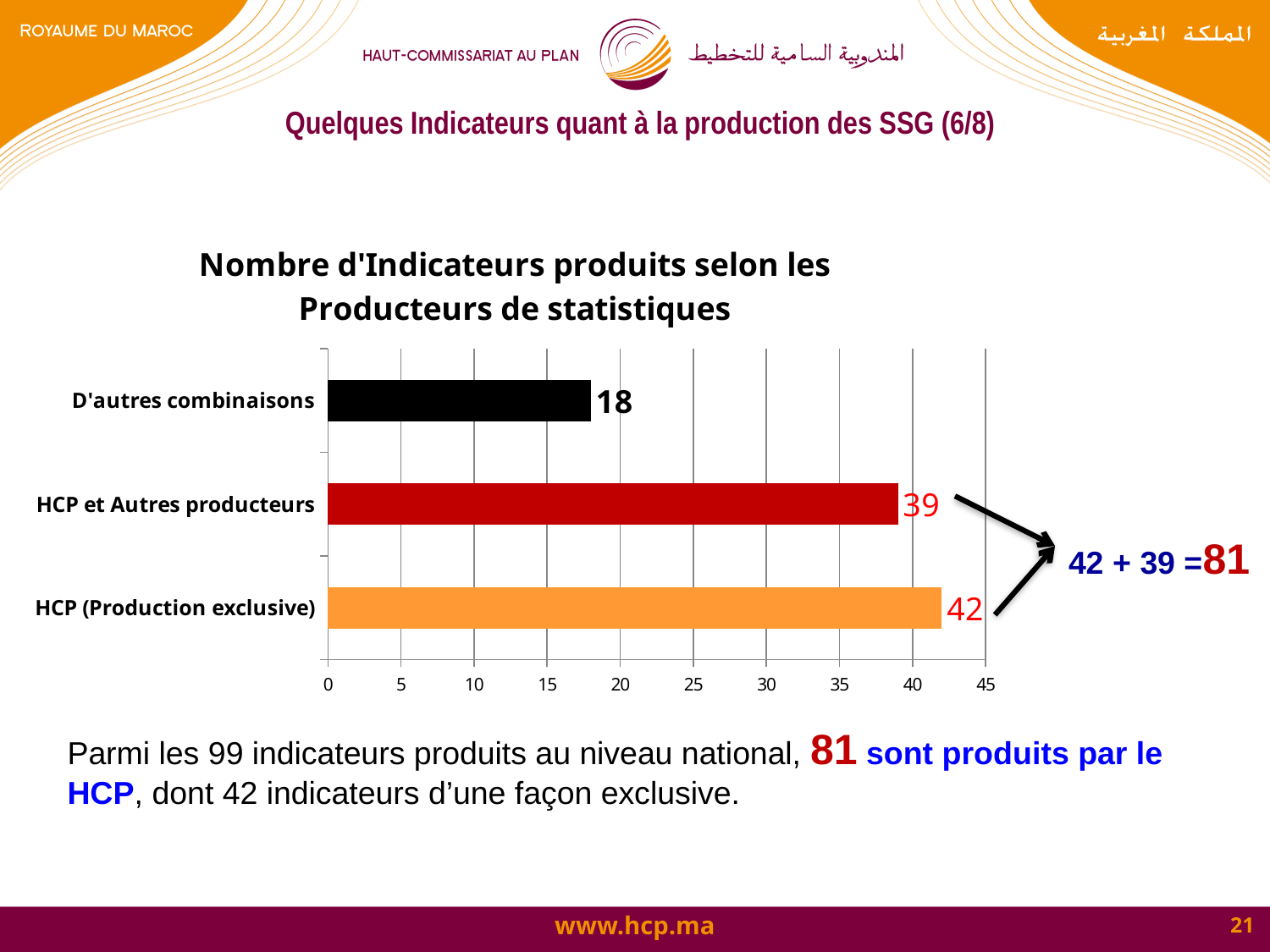
Which is larger, the value for HCP et Autres producteurs or the value for D'autres combinaisons? HCP et Autres producteurs What is the difference between the values for HCP (Production exclusive) and HCP et Autres producteurs? 3 Which category has the lowest value? D'autres combinaisons What is the value for HCP et Autres producteurs? 39 What is the value for D'autres combinaisons? 18 What is the difference between the values for HCP et Autres producteurs and D'autres combinaisons? 21 What kind of chart is shown on the slide? bar chart What is the value for HCP (Production exclusive)? 42 What is the title of the chart? Nombre d'Indicateurs produits selon les Producteurs de statistiques How many categories are shown in the chart? 3 Is the value for D'autres combinaisons greater or less than 20? less Which category has the highest value? HCP (Production exclusive)